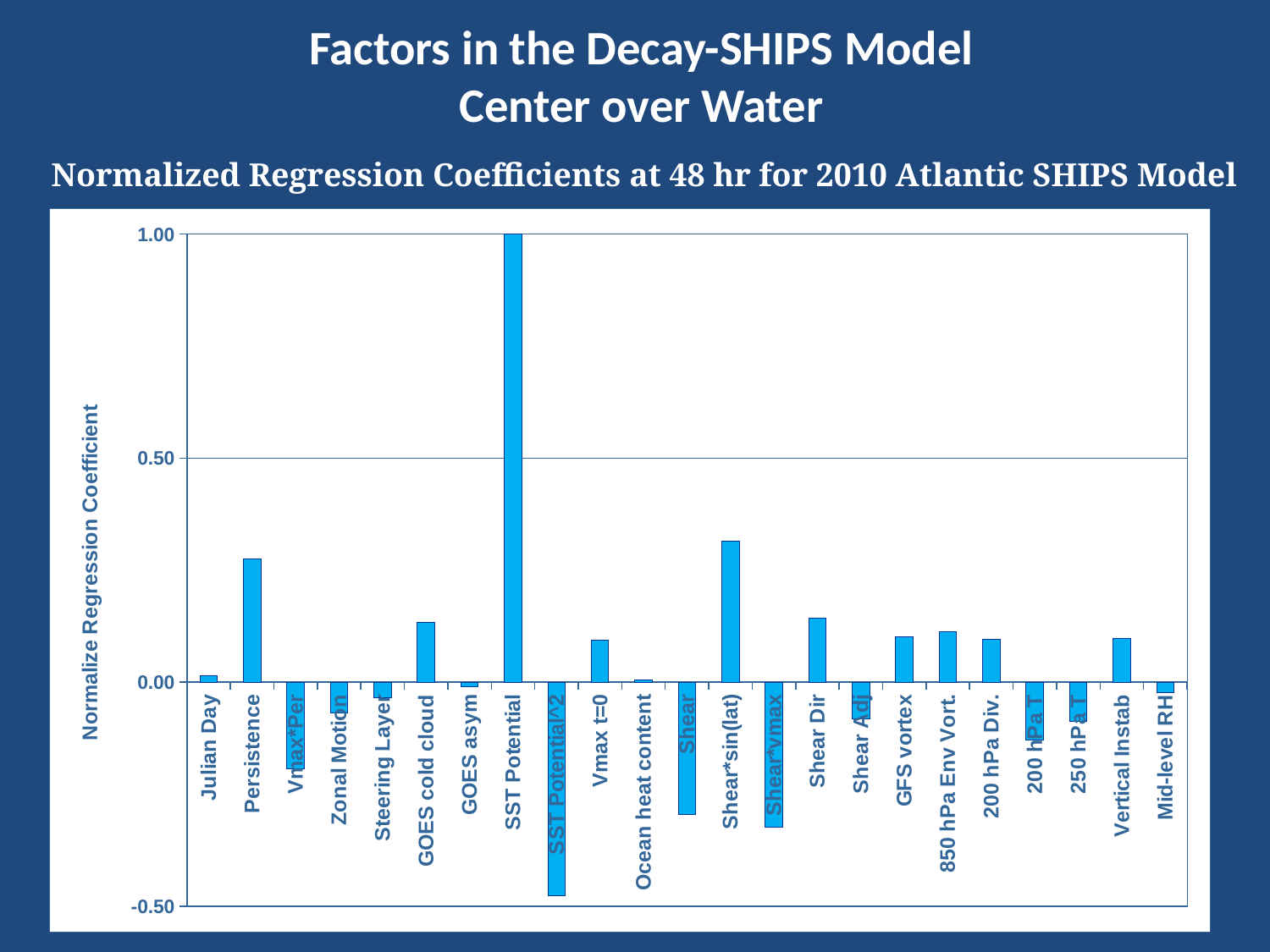
Which factor has the highest normalized regression coefficient? SST Potential Is the value for Persistence greater or less than 0.50? less How many factors (categories) are plotted on the x axis? 23 Which factor has the lowest normalized regression coefficient? SST Potential^2 Is the value for Mid-level RH greater or less than 0.00? less What is the label of the vertical axis? Normalize Regression Coefficient Which has the larger value, Persistence or GOES cold cloud? Persistence Which has the larger value, Vertical Instab or Shear Adj? Vertical Instab Is the value for Shear greater or less than 0.00? less What is the normalized regression coefficient for SST Potential? 1.00 What type of chart is shown on the slide? bar chart